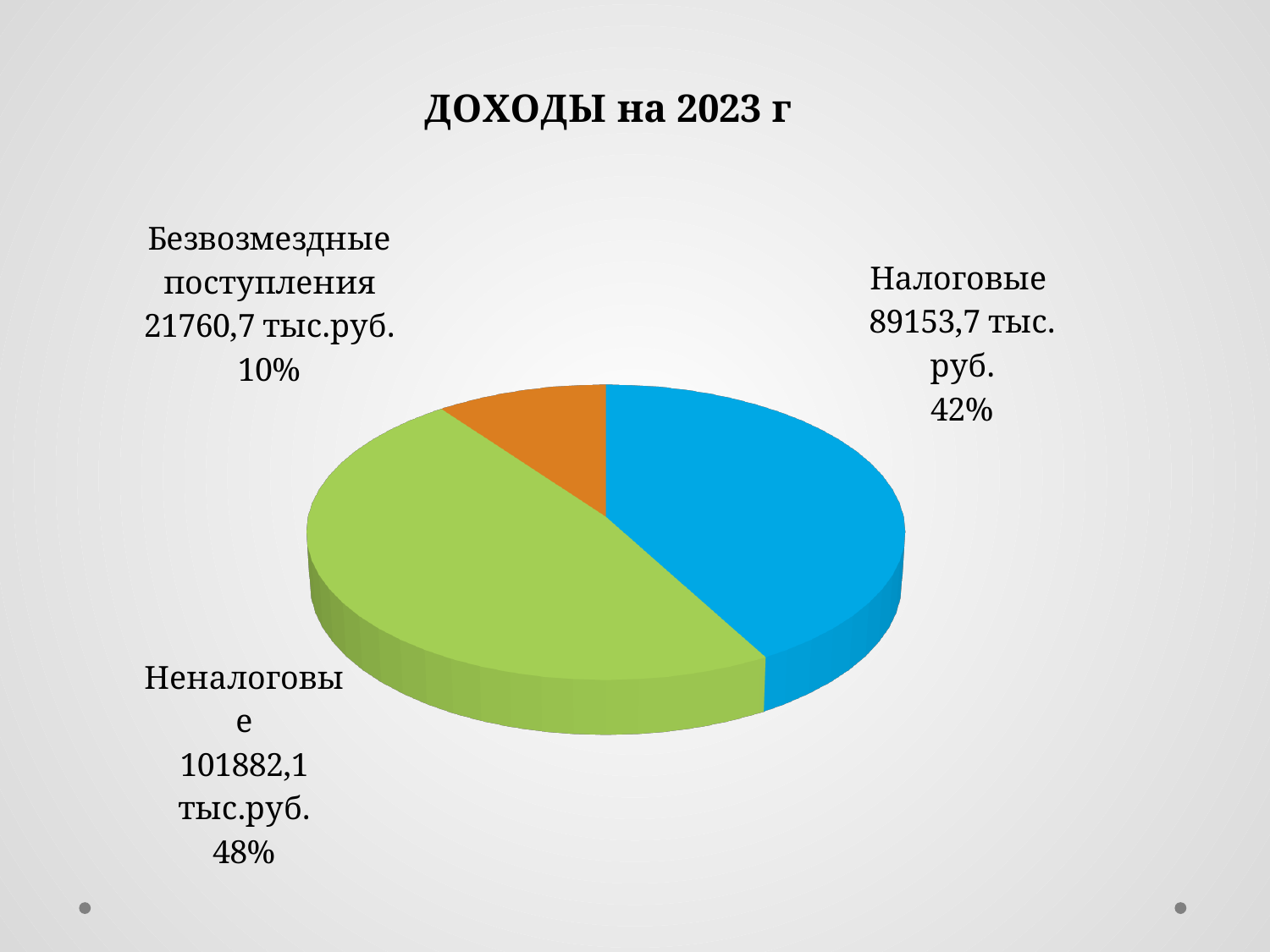
What is the value for Безвозмездные поступления? 21760,7 тыс.руб. Which is larger, Налоговые or Неналоговые? Неналоговые What is the title of the chart? ДОХОДЫ на 2023 г What type of chart is shown on the slide? pie chart What is the difference between Неналоговые and Налоговые in тыс.руб.? 12728,4 тыс.руб. What is the value for Налоговые? 89153,7 тыс.руб. What share of the pie does Налоговые represent? 42% How many slices does the pie chart have? 3 What is the value for Неналоговые? 101882,1 тыс.руб. What share of the pie does Безвозмездные поступления represent? 10% Which category has the smallest slice? Безвозмездные поступления Which category has the largest slice? Неналоговые